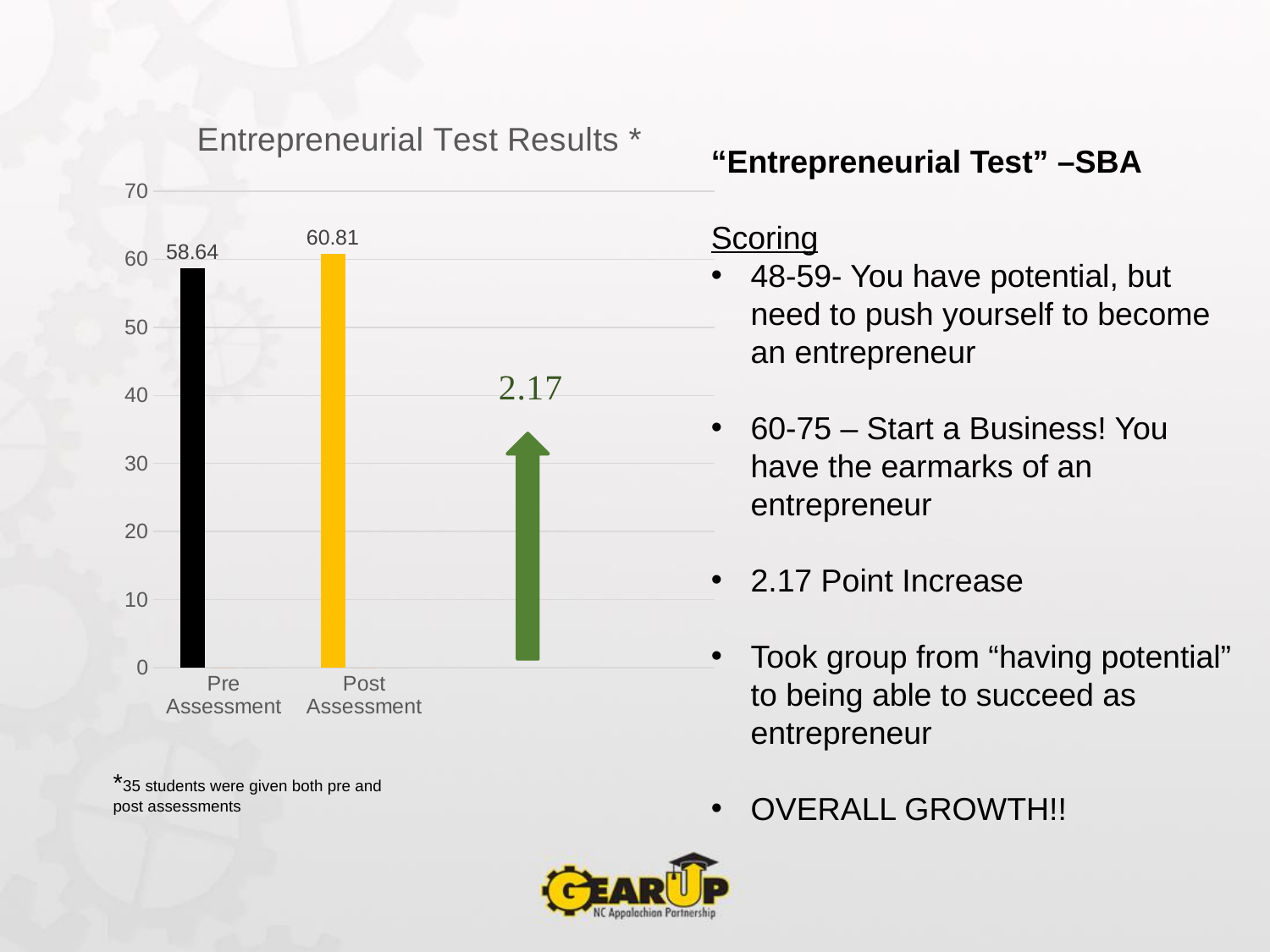
What is the difference between the Post Assessment and Pre Assessment values? 2.17 Which category has the lowest value? Pre Assessment What kind of chart is shown on the slide? bar chart Do the values rise or fall from Pre Assessment to Post Assessment? rise Which category has the higher value, Pre Assessment or Post Assessment? Post Assessment What is the title of the chart? Entrepreneurial Test Results * What colour is the Post Assessment bar? yellow What is the value for Post Assessment? 60.81 Is the value for Post Assessment greater or less than 60? greater How many categories are shown on the x axis of the chart? 2 Is the value for Pre Assessment greater or less than 60? less What is the value for Pre Assessment? 58.64